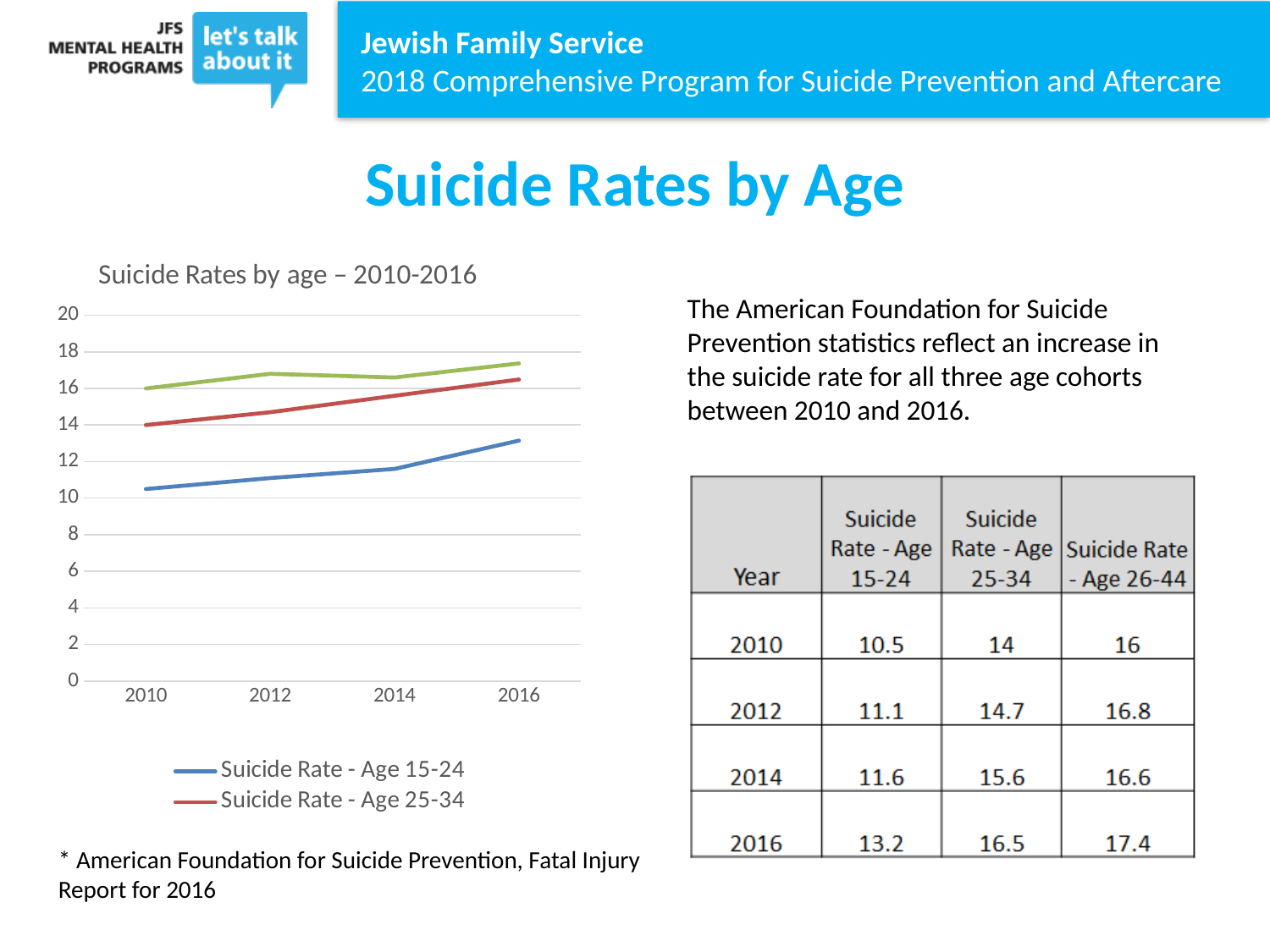
Is the value for Suicide Rate - Age 15-24 in 2014 greater or less than 12? less How many series does the chart's legend list? 2 Is the value for Suicide Rate - Age 25-34 in 2014 greater or less than 16? less Does the Suicide Rate - Age 15-24 line rise or fall from 2010 to 2016? rise Is the value for Suicide Rate - Age 25-34 in 2016 greater or less than 16? greater What is the title of the chart on the slide? Suicide Rates by age – 2010-2016 How many years are labelled on the x axis of the chart? 4 What kind of chart is shown on the slide? line chart In 2016, which is higher: Suicide Rate - Age 15-24 or Suicide Rate - Age 25-34? Suicide Rate - Age 25-34 What colour is the Suicide Rate - Age 15-24 line in the chart? blue